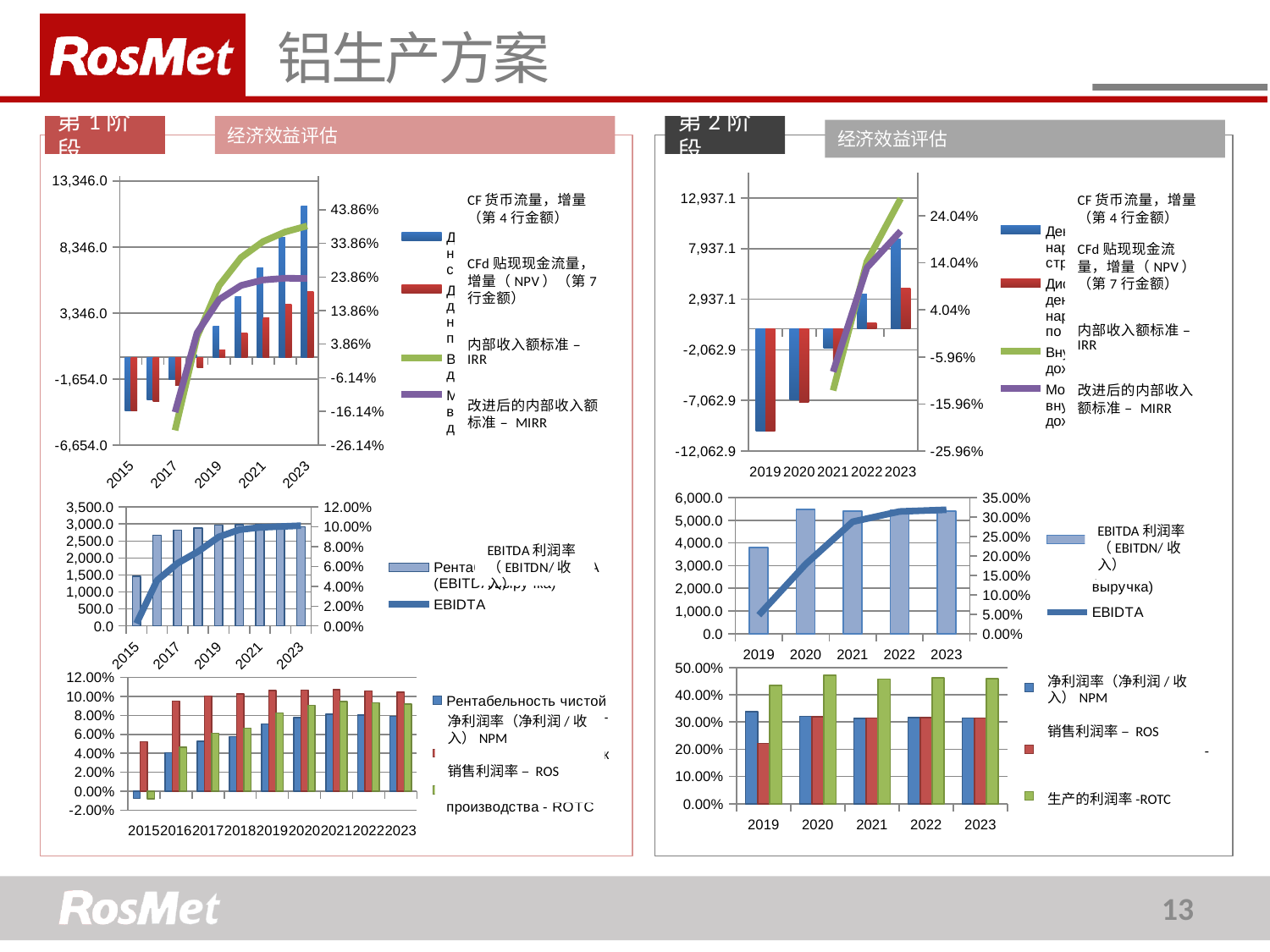
In the bottom-right chart (Stage 2 profitability), is the ROS (red) value for 2019 greater or less than 30.00%? less In the bottom-right chart (Stage 2 profitability), which series has the highest value in 2019? 生产的利润率 -ROTC In the bottom-right chart (Stage 2 profitability), is the ROTC (green) value for 2019 greater or less than 40.00%? greater In the bottom-left chart (Stage 1 profitability), how many years are shown on the x axis? 9 In the middle-left chart (Stage 1 EBITDA), does the EBITDA line rise or fall from 2015 to 2023? rise How many series does the legend of the middle-right chart (Stage 2 EBITDA) list? 2 How many series does the legend of the bottom-right chart (Stage 2 profitability) list? 3 What kind of chart is the bottom-right chart (Stage 2 profitability)? bar chart In the bottom-right chart (Stage 2 profitability), which is larger in 2019: the NPM (blue) bar or the ROS (red) bar? NPM (blue) In the bottom-right chart (Stage 2 profitability), how many years are shown on the x axis? 5